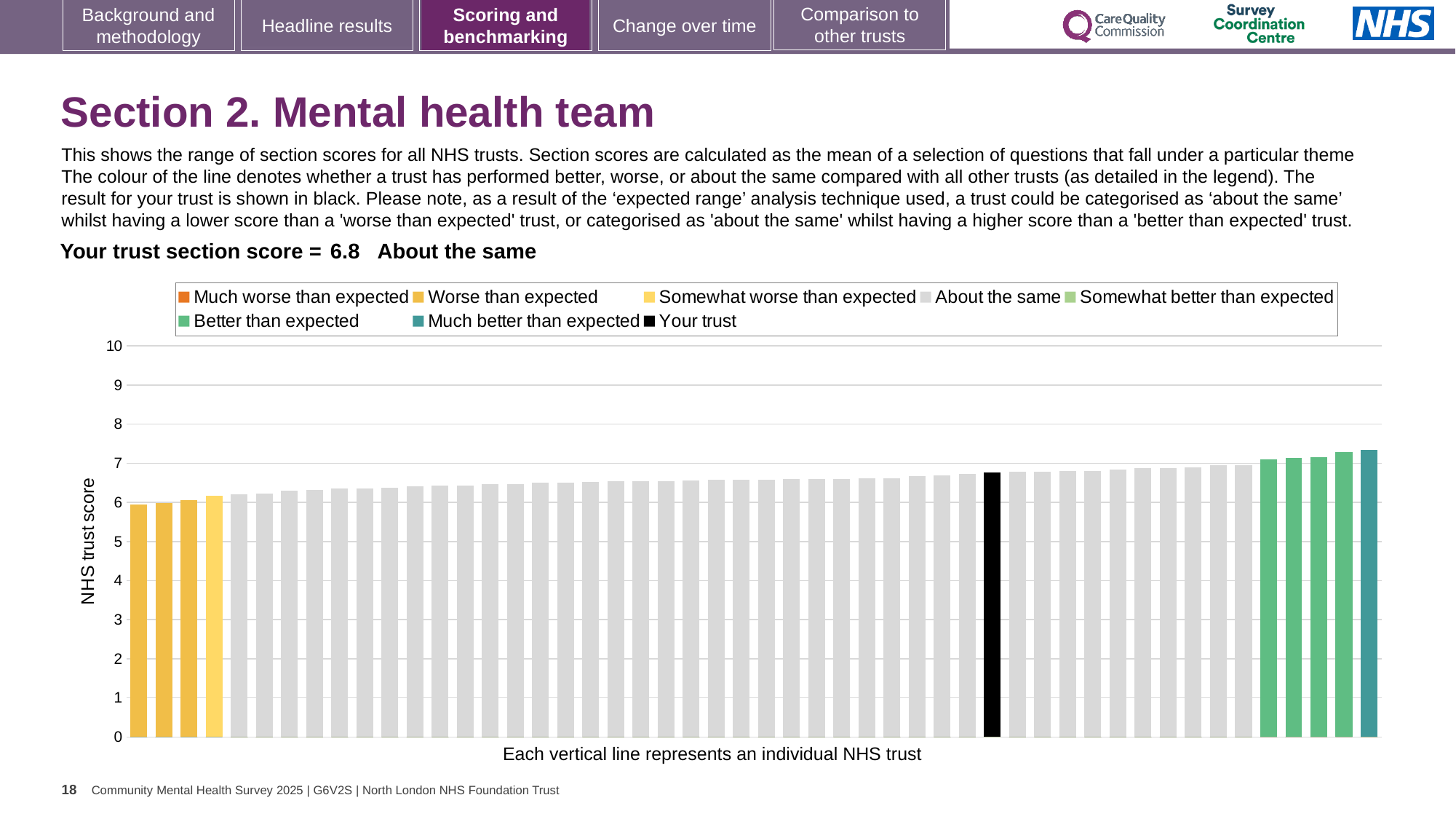
Is the value of the tallest bar in the chart greater or less than 8? less How many entries does the chart legend list? 8 Is the value of the black 'Your trust' bar greater or less than 6? greater How many bars are coloured as 'Better than expected'? 4 What is the section score for your trust shown on the slide? 6.8 Do the bar values rise or fall from left to right along the x axis? rise How many bars are coloured as 'Much better than expected'? 1 What kind of chart is shown on the slide? bar chart Which category is your trust placed in according to the slide? About the same Is the value of the shortest bar in the chart greater or less than 5? greater What is the label on the vertical axis of the chart? NHS trust score Which is taller, the leftmost bar or the rightmost bar? the rightmost bar